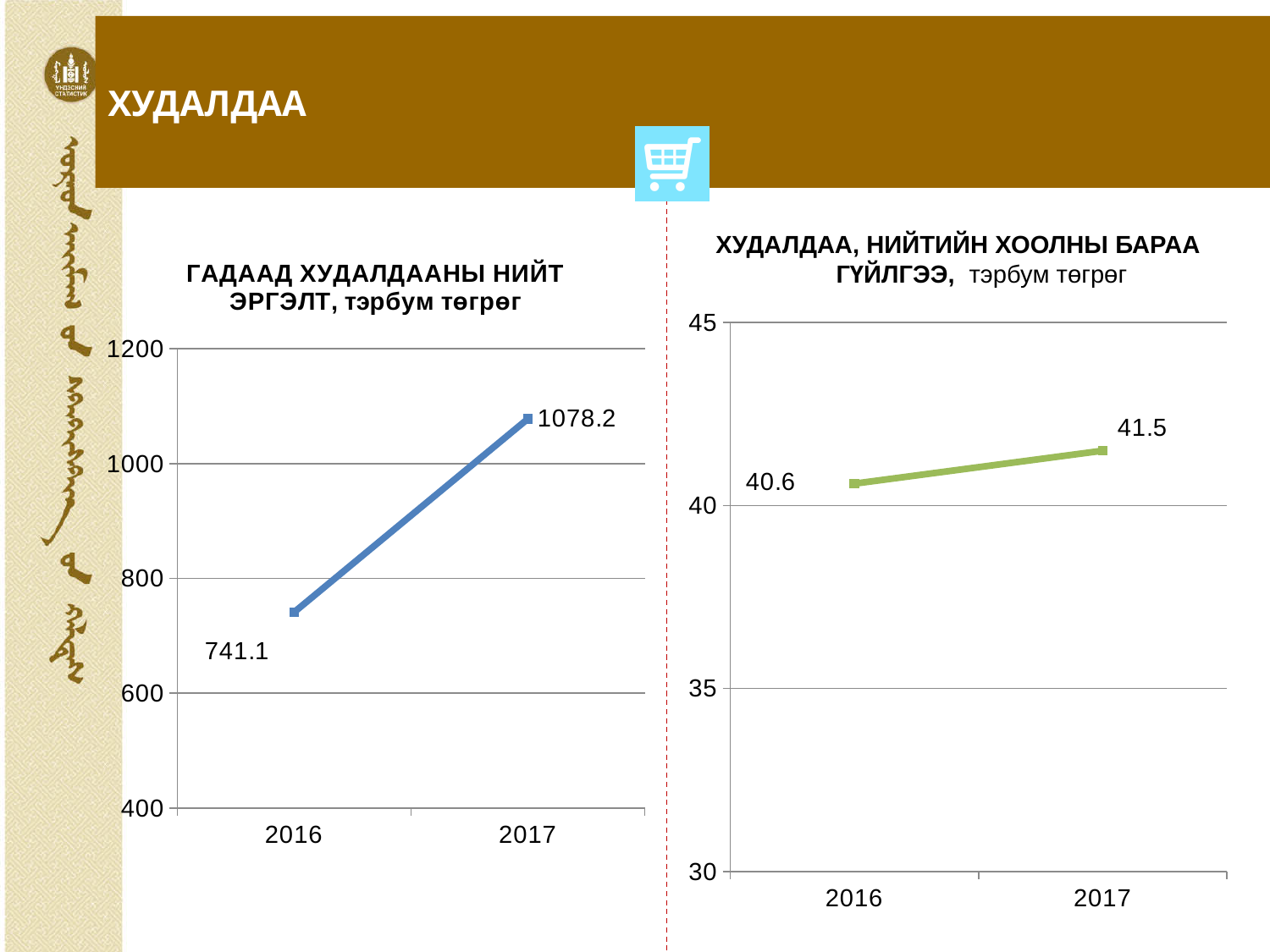
What kind of chart is the left chart? Line chart In the right chart, do the values rise or fall from 2016 to 2017? Rise In the left chart, which year has the higher value? 2017 How many data points are plotted in the left chart? 2 In the right chart (ХУДАЛДАА, НИЙТИЙН ХООЛНЫ БАРАА ГҮЙЛГЭЭ), what is the value for 2017? 41.5 In the left chart, is the value for 2017 greater or less than 1000? greater In the left chart, by how much did the value increase from 2016 to 2017? 337.1 In the left chart (ГАДААД ХУДАЛДААНЫ НИЙТ ЭРГЭЛТ), what is the value for 2016? 741.1 In the right chart (ХУДАЛДАА, НИЙТИЙН ХООЛНЫ БАРАА ГҮЙЛГЭЭ), what is the value for 2016? 40.6 In the right chart, what is the difference between the 2017 and 2016 values? 0.9 In the right chart, which year has the lower value? 2016 In the left chart (ГАДААД ХУДАЛДААНЫ НИЙТ ЭРГЭЛТ), what is the value for 2017? 1078.2